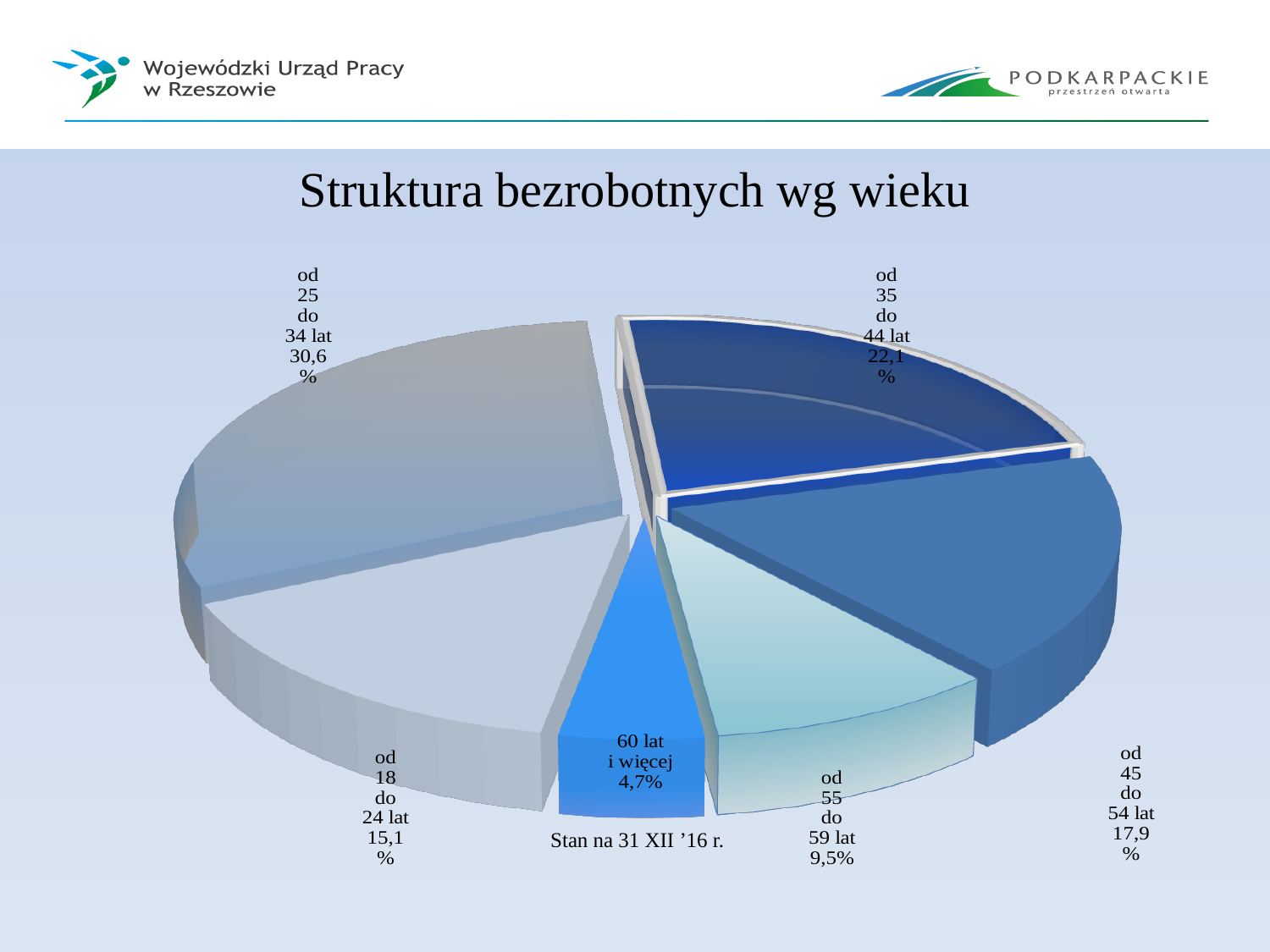
Which age group has the smallest share of the pie? 60 lat i więcej What is the difference between the shares for od 35 do 44 lat and od 55 do 59 lat? 12,6 percentage points Which age group has the largest share of the pie? od 25 do 34 lat How many slices does the pie chart have? 6 What is the value shown for od 45 do 54 lat? 17,9% What is the value shown for od 18 do 24 lat? 15,1% What is the title of the chart? Struktura bezrobotnych wg wieku What share of the pie is the slice for od 25 do 34 lat? 30,6% Which is larger, the share for od 45 do 54 lat or the share for od 18 do 24 lat? od 45 do 54 lat What kind of chart is shown on the slide? pie chart What is the value shown for 60 lat i więcej? 4,7% What is the value shown for od 35 do 44 lat? 22,1%